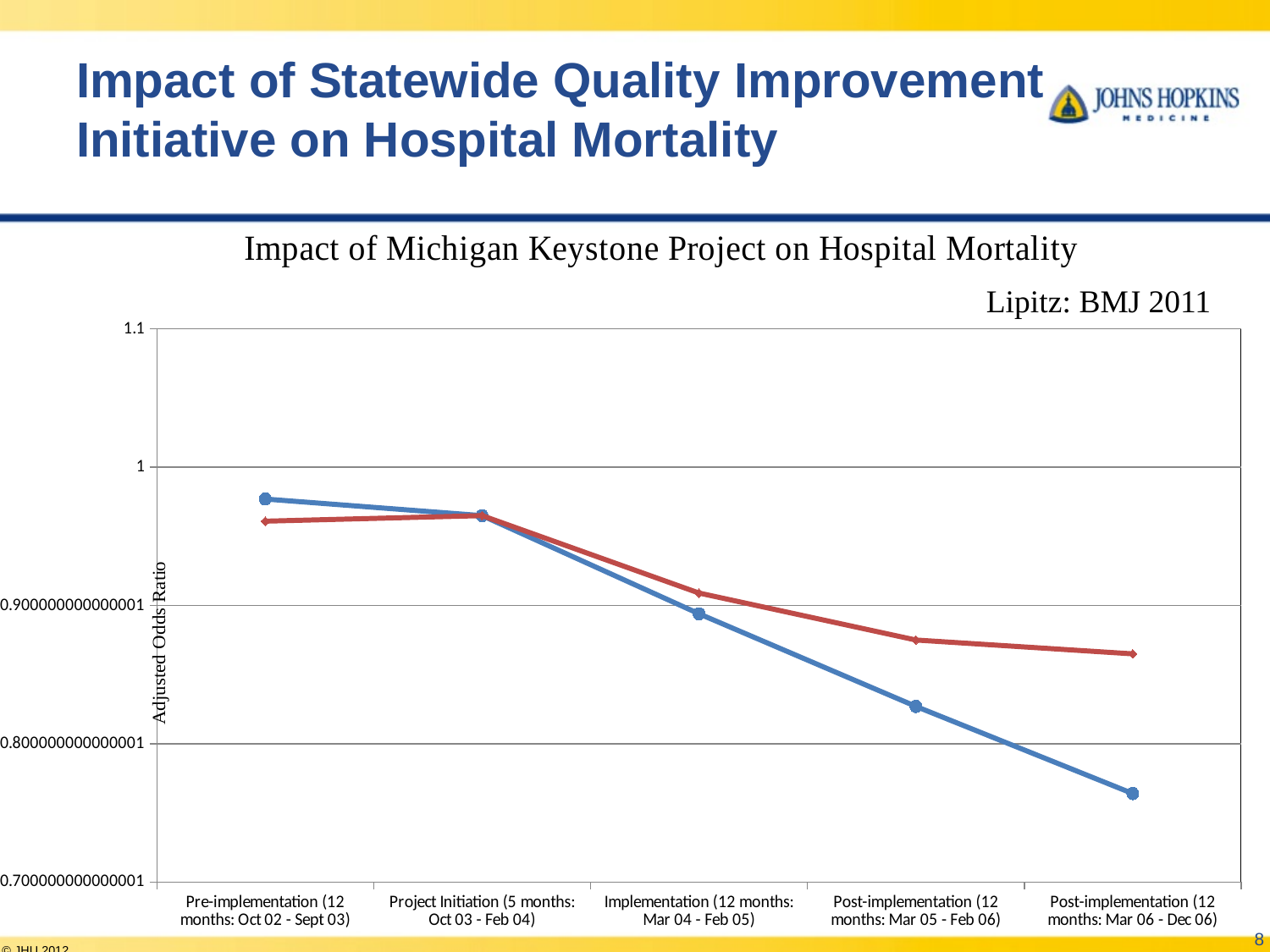
In which period does the blue line reach its lowest value? Post-implementation (12 months: Mar 06 - Dec 06) What is the title of the chart? Impact of Michigan Keystone Project on Hospital Mortality What is the label of the y axis? Adjusted Odds Ratio How many lines are plotted on the chart? 2 Is the blue line's value for Post-implementation (12 months: Mar 05 - Feb 06) greater or less than 0.8? greater Is the red line's value for Post-implementation (12 months: Mar 06 - Dec 06) greater or less than 0.9? less Does the red line rise or fall from the Project Initiation period to the Post-implementation (12 months: Mar 06 - Dec 06) period? fall How many time-period categories are shown on the x axis? 5 What kind of chart is shown on the slide? line chart At Post-implementation (12 months: Mar 06 - Dec 06), which line has the higher value, the blue line or the red line? red line Is the blue line's value for Post-implementation (12 months: Mar 06 - Dec 06) greater or less than 0.8? less Does the blue line rise or fall from the Pre-implementation period to the Post-implementation (12 months: Mar 06 - Dec 06) period? fall